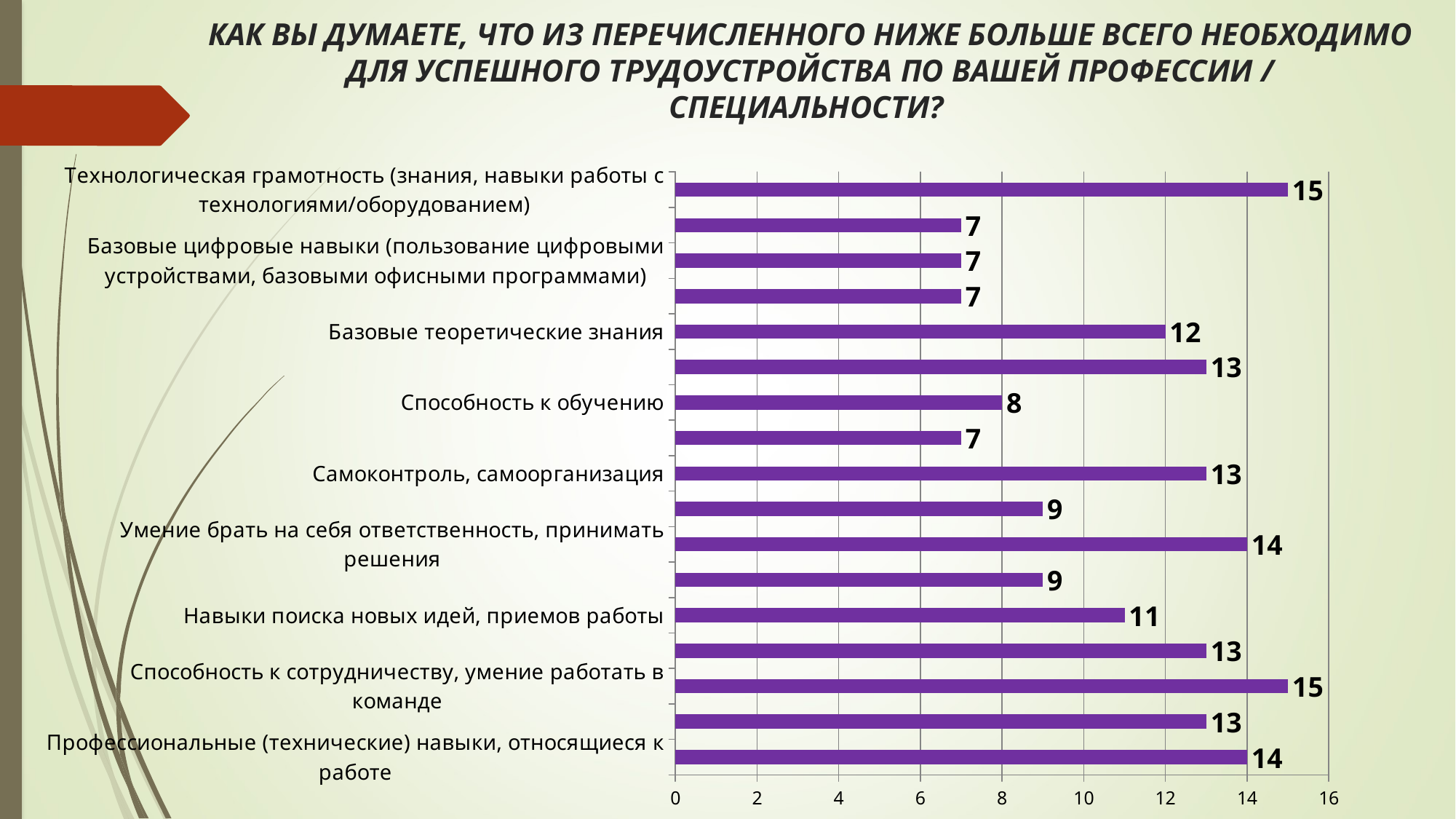
What is the value for "Технологическая грамотность (знания, навыки работы с технологиями/оборудованием)"? 15 How many bars are plotted in the chart? 17 What type of chart is shown on the slide? bar chart What is the lowest value shown by any bar in the chart? 7 What is the difference between the values for "Способность к сотрудничеству, умение работать в команде" and "Способность к обучению"? 7 What is the value for "Способность к обучению"? 8 What is the value for "Профессиональные (технические) навыки, относящиеся к работе"? 14 What is the value for "Базовые теоретические знания"? 12 What is the value for "Навыки поиска новых идей, приемов работы"? 11 What is the highest value shown by any bar in the chart? 15 What is the value for "Самоконтроль, самоорганизация"? 13 Which is larger: the value for "Умение брать на себя ответственность, принимать решения" or the value for "Базовые теоретические знания"? Умение брать на себя ответственность, принимать решения